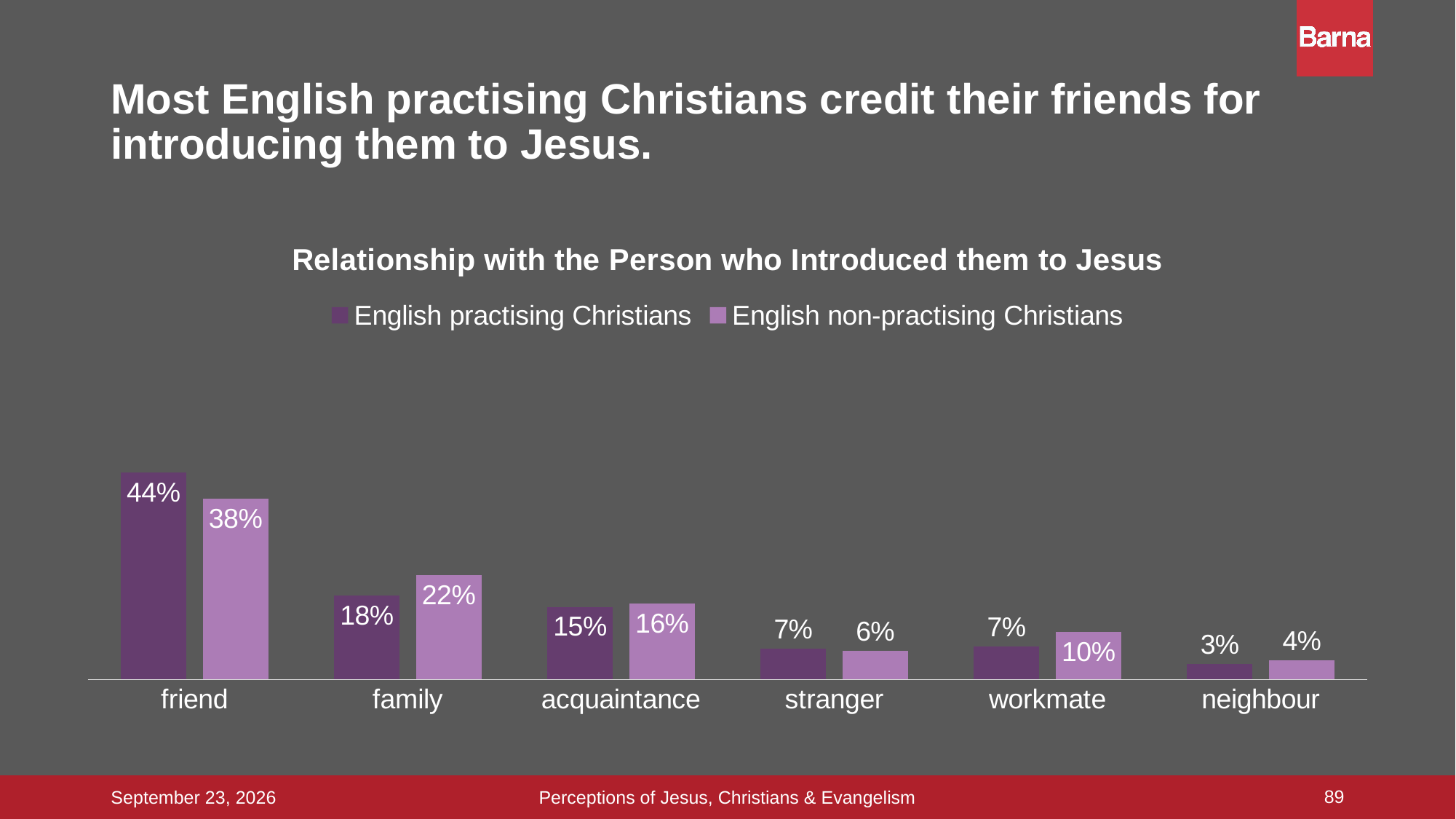
What is the difference between English practising Christians and English non-practising Christians in the friend category? 6% How many series does the legend list? 2 In the family category, which series has the larger value? English non-practising Christians What is the value for English practising Christians in the workmate category? 7% What is the title of the chart? Relationship with the Person who Introduced them to Jesus How many categories are shown on the x axis? 6 What kind of chart is shown on the slide? bar chart Which category has the lowest value for English practising Christians? neighbour What is the difference between the two series in the workmate category? 3% What percentage of English practising Christians credit a friend for introducing them to Jesus? 44% Which category has the highest value for English non-practising Christians? friend What is the value for English non-practising Christians in the family category? 22%